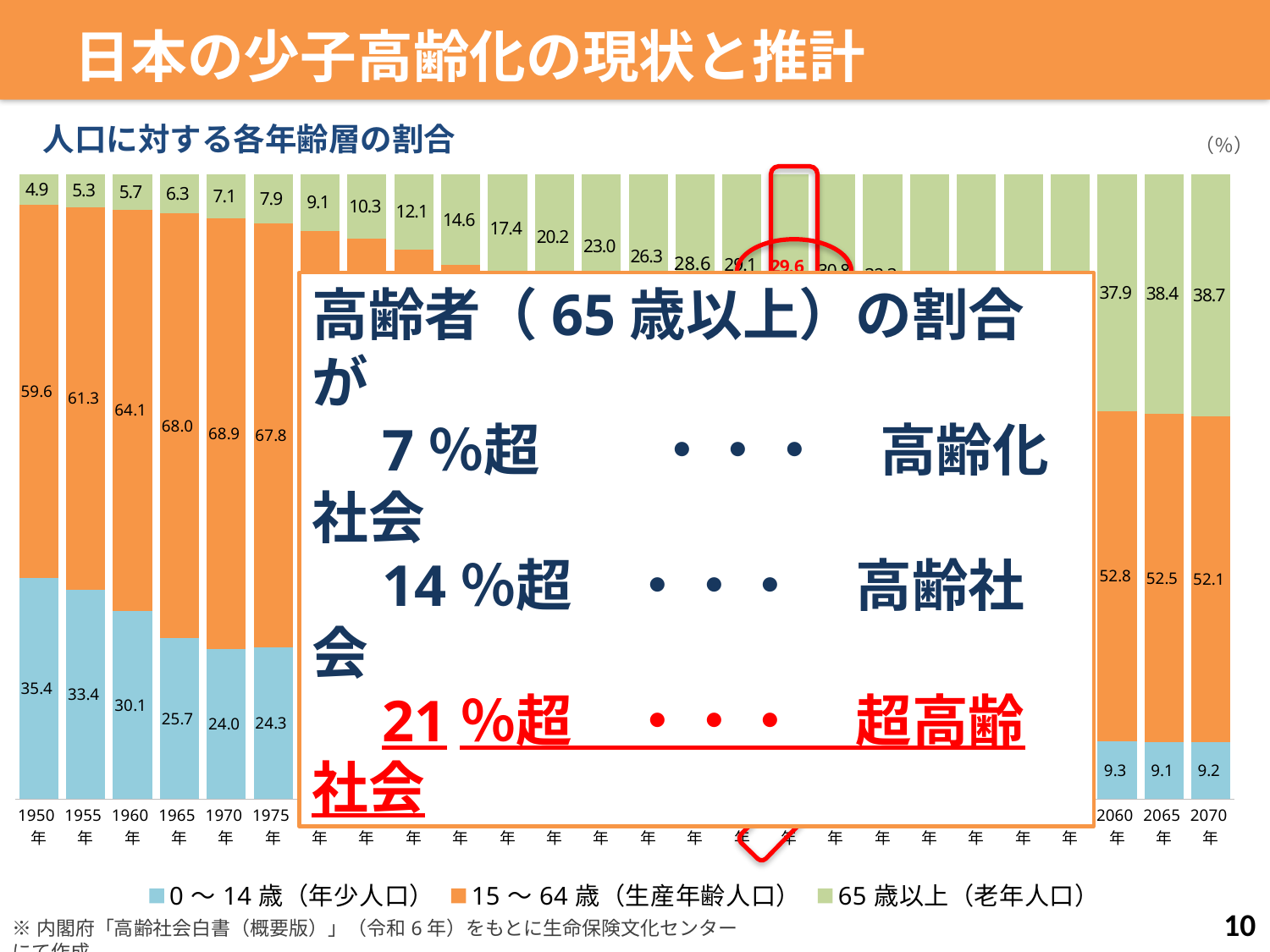
Which is larger, the 0～14歳 share in 1950 or the 65歳以上 share in 2070? 65歳以上 share in 2070 What is the share of the 0～14歳 (年少人口) group in 2070? 9.2 Which 65歳以上 value is highlighted in red on the chart? 29.6 Does the share of the 65歳以上 group rise or fall from 1950 to 2070? rise Among the years 2060, 2065 and 2070, which year has the lowest share of the 0～14歳 group? 2065年 What is the share of the 65歳以上 (老年人口) group in 1950? 4.9 What is the difference between the 65歳以上 share in 2070 and in 1950? 33.8 What is the share of the 65歳以上 group in 2065? 38.4 Among the years 1950 to 1975, which year has the highest share of the 15～64歳 group? 1970年 What is the share of the 15～64歳 (生産年齢人口) group in 1970? 68.9 What kind of chart is shown on the slide? stacked bar chart How many series does the legend list? 3